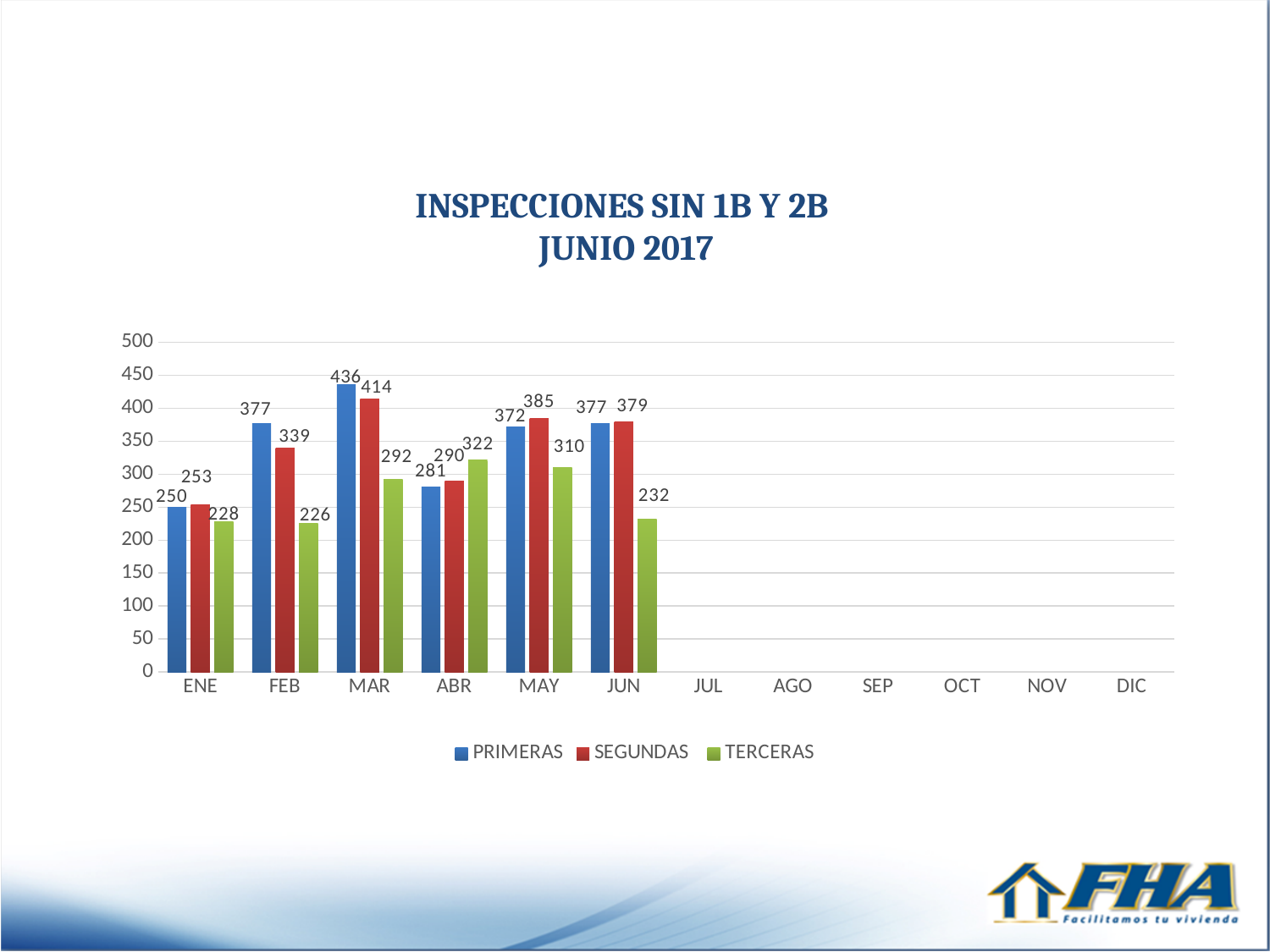
What is the SEGUNDAS value for JUN? 379 Which is larger, the PRIMERAS value for MAY or the SEGUNDAS value for MAY? SEGUNDAS (385) Which month has the highest PRIMERAS value? MAR What is the difference between the SEGUNDAS values for MAR and ENE? 161 Which month has the lowest TERCERAS value? FEB How many months on the x axis have data plotted? 6 What is the TERCERAS value for ABR? 322 What is the PRIMERAS value for MAR? 436 What is the title of the chart? INSPECCIONES SIN 1B Y 2B JUNIO 2017 How many series does the legend list? 3 What kind of chart is shown? Bar chart Does the TERCERAS series rise or fall from MAY to JUN? Fall